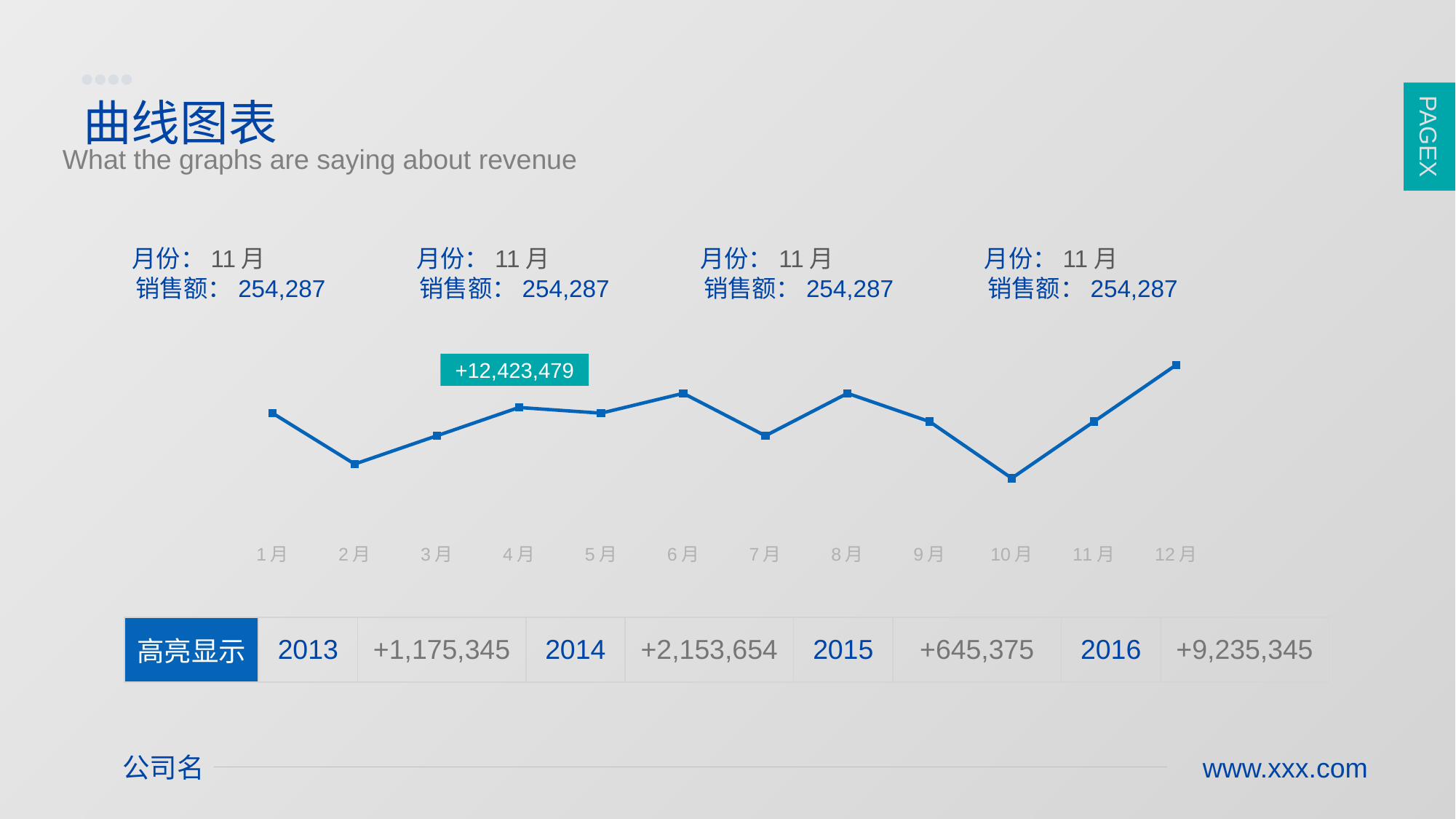
Which is higher on the line chart, the value for 2月 or the value for 12月? 12月 Which is higher on the line chart, the value for 1月 or the value for 2月? 1月 Which month has the lowest value on the line chart? 10月 Which is higher on the line chart, the value for 3月 or the value for 4月? 4月 Which month has the highest value on the line chart? 12月 Does the line rise or fall from 1月 to 2月? fall Does the line rise or fall from 8月 to 10月? fall How many months are plotted along the x axis of the line chart? 12 What kind of chart is shown on the slide? line chart Does the line rise or fall from 10月 to 12月? rise What is the English subtitle shown under the slide title above the chart? What the graphs are saying about revenue